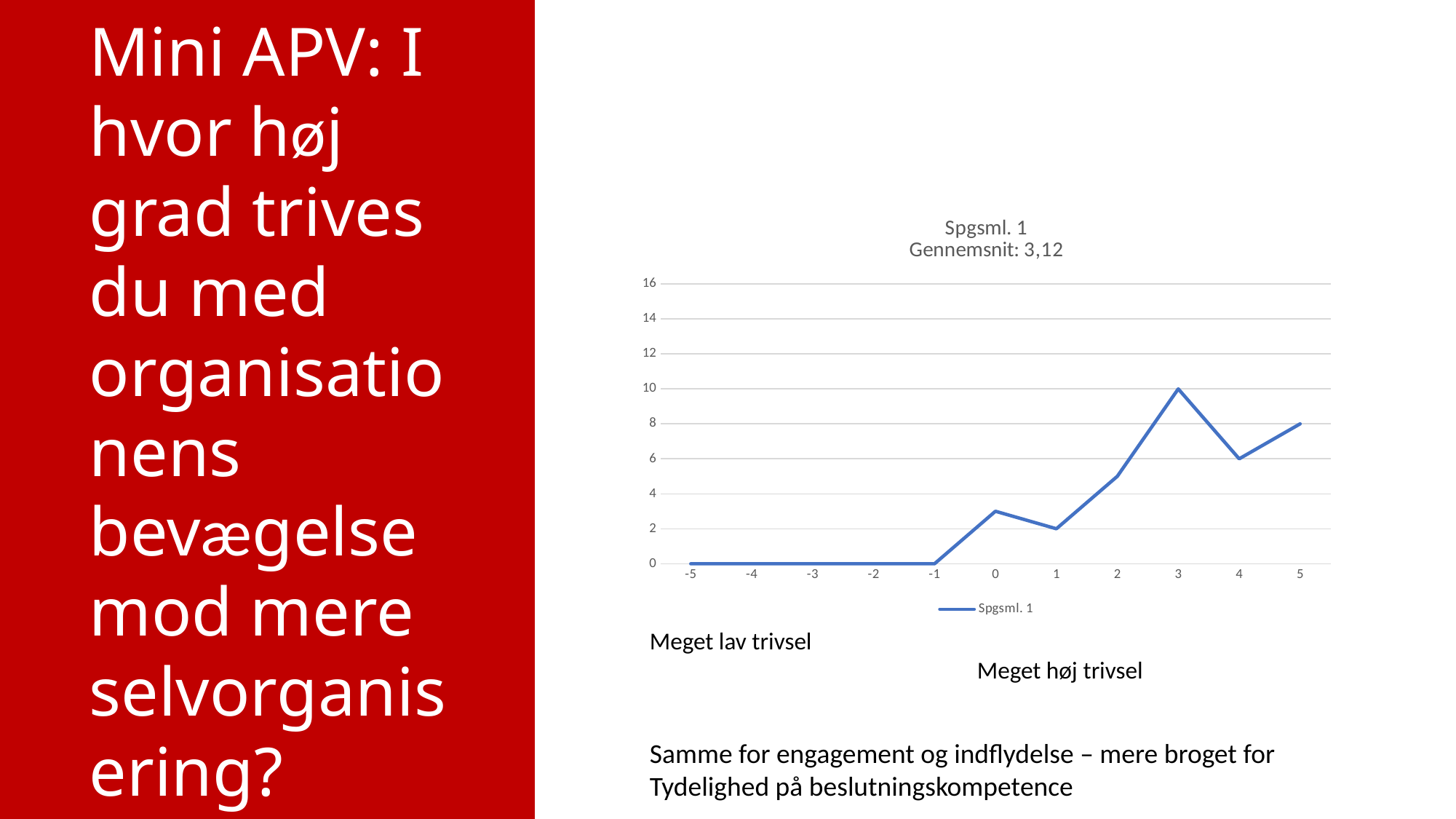
How many series does the legend list? 1 What is the value at x = 5? 8 What is the value at x = 3? 10 Which is larger, the value at x = 5 or the value at x = 4? x = 5 What is the value at x = -3? 0 How many x-axis categories are plotted? 11 At which x value does the line reach its highest point? 3 What kind of chart is shown on the slide? line chart What is the value at x = 4? 6 Is the value at x = 2 greater or less than 4? greater What average (Gennemsnit) is stated in the chart title? 3,12 What is the difference between the values at x = 3 and x = 4? 4